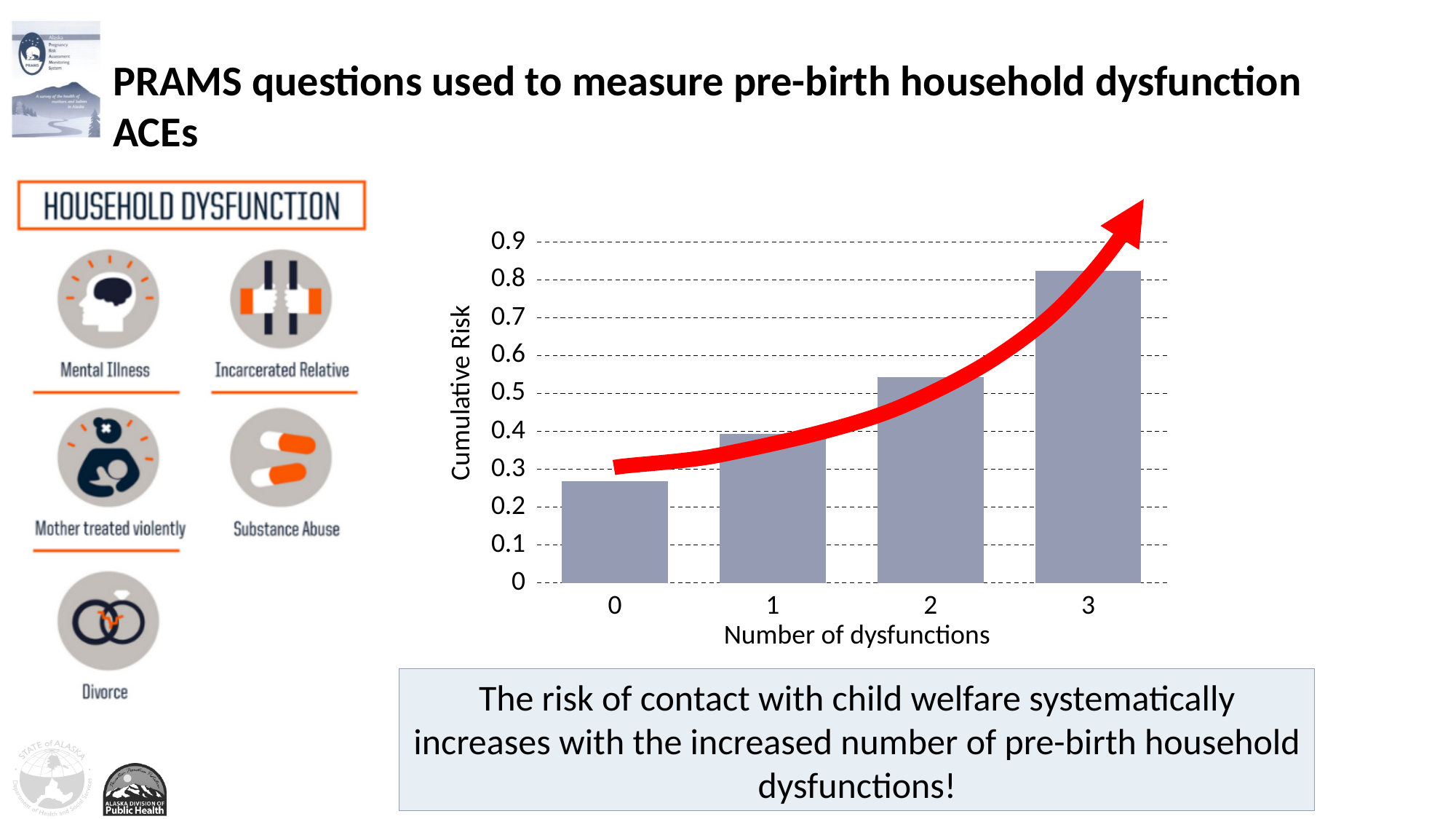
How many bars (categories) are plotted in the chart? 4 What is the label of the vertical axis of the chart? Cumulative Risk Which has a higher cumulative risk: 1 dysfunction or 2 dysfunctions? 2 dysfunctions Is the cumulative risk for 1 dysfunction greater or less than 0.3? greater Which number of dysfunctions has the highest cumulative risk? 3 Is the cumulative risk for 3 dysfunctions greater or less than 0.9? less Which number of dysfunctions has the lowest cumulative risk? 0 Does the cumulative risk rise or fall as the number of dysfunctions increases? rise Is the cumulative risk for 3 dysfunctions greater or less than 0.7? greater What kind of chart is shown on the slide? bar chart